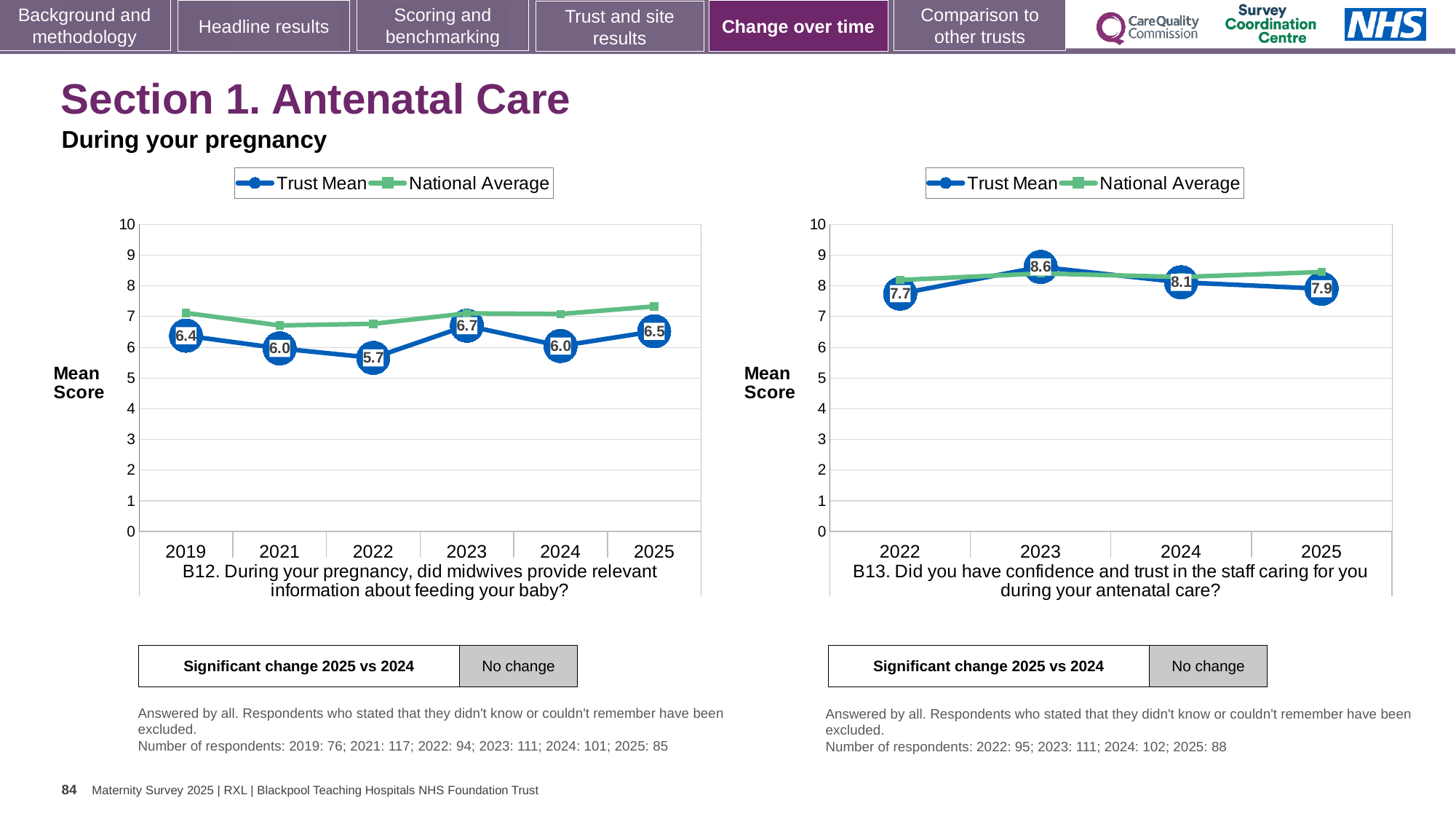
In the B12 chart (left), what is the difference between the Trust Mean in 2023 and in 2022? 1.0 In the B13 chart (right), which year has the lowest Trust Mean? 2022 In the B12 chart (left), how many years are shown on the x axis? 6 In the B12 chart (left), what is the Trust Mean for 2022? 5.7 In the B13 chart (right), what is the Trust Mean for 2023? 8.6 In the B13 chart (right), is the Trust Mean higher in 2024 or in 2025? 2024 In the B13 chart (right), does the Trust Mean rise or fall from 2023 to 2025? fall In the B12 chart (left), which year has the lowest Trust Mean? 2022 How many series does the legend of the B13 chart (right) list? 2 In the B12 chart (left), is the National Average for 2025 greater or less than 7? greater In the B12 chart (left), which year has the highest Trust Mean? 2023 In the B12 chart (left), what is the Trust Mean for 2025? 6.5